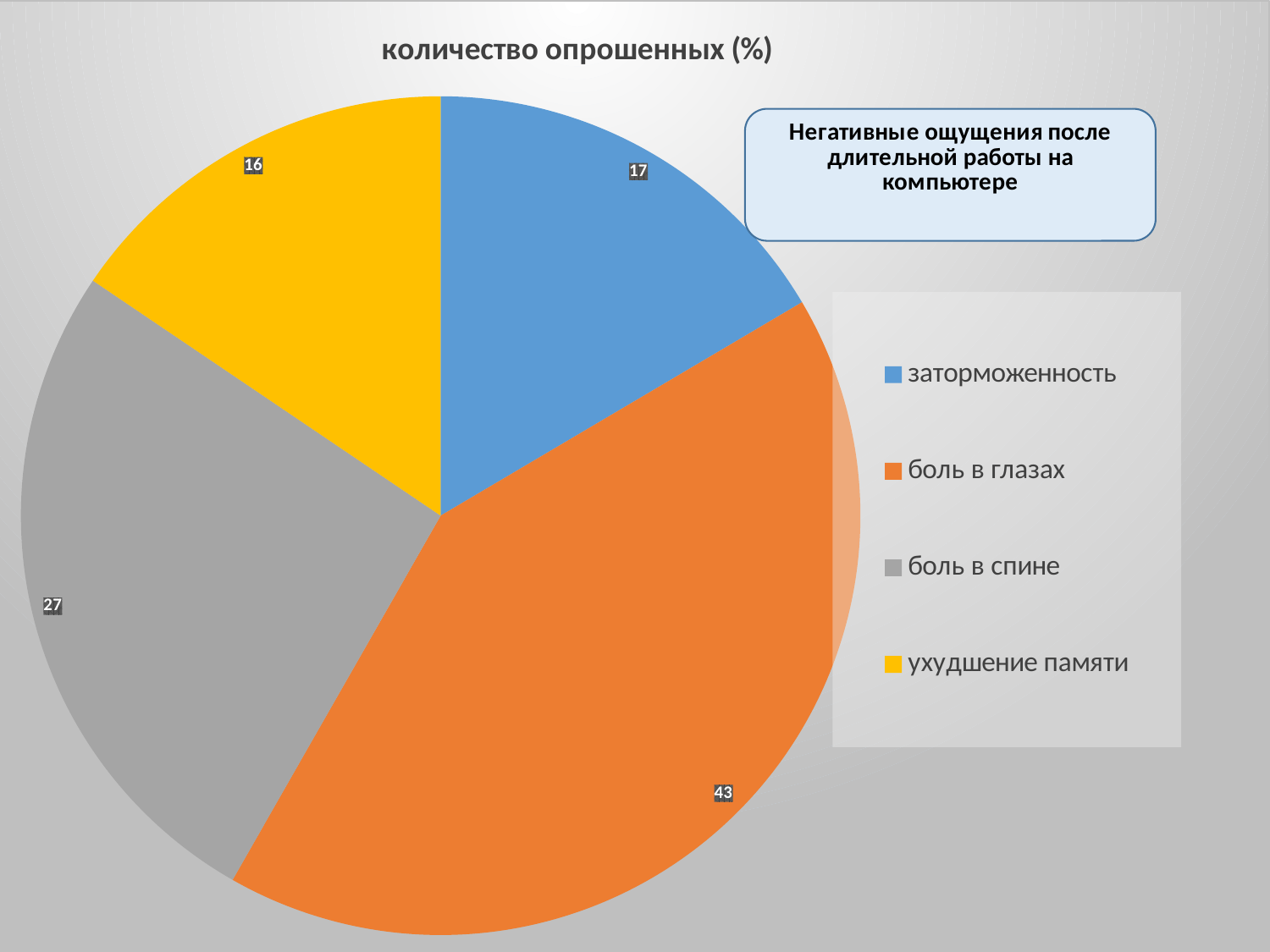
What kind of chart is shown on the slide? pie chart What is the title of the chart? количество опрошенных (%) What is the value for боль в спине? 27 What is the value for заторможенность? 17 Which colour represents боль в спине in the legend? gray How many categories does the pie chart have? 4 Which category has the largest slice? боль в глазах What is the difference between the values for боль в глазах and боль в спине? 16 What is the value for боль в глазах? 43 Which category has the smallest slice? ухудшение памяти What is the value for ухудшение памяти? 16 Which is larger, the value for боль в спине or the value for заторможенность? боль в спине